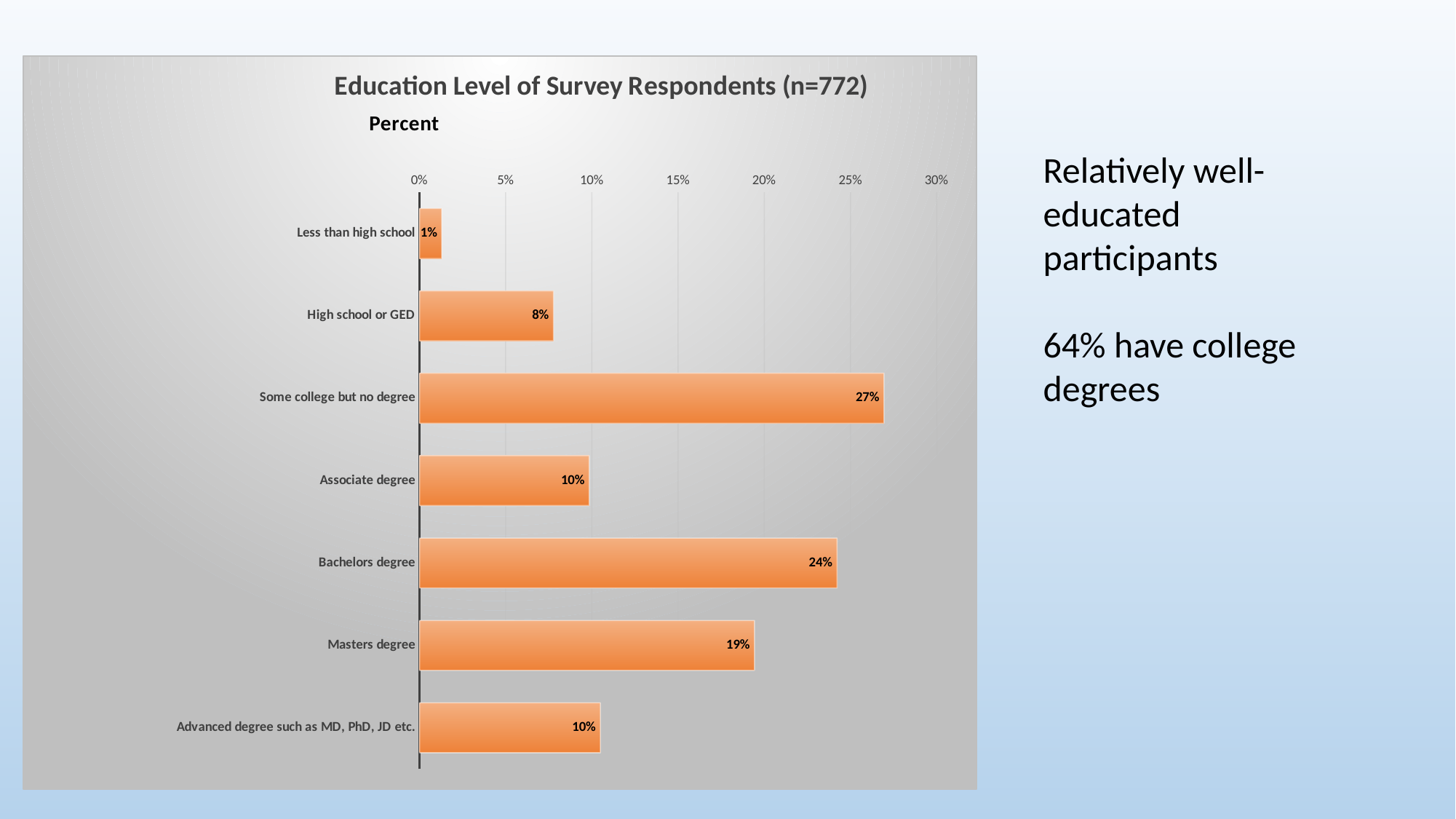
How many education level categories are shown in the chart? 7 What percentage of respondents have High school or GED as their education level? 8% Is the value for Bachelors degree greater or less than 20%? greater Which education level has the lowest percentage of respondents? Less than high school What is the title of the chart? Education Level of Survey Respondents (n=772) Which education level has the highest percentage of respondents? Some college but no degree Which is larger, the value for Masters degree or the value for Associate degree? Masters degree What is the difference in percentage points between Some college but no degree and Bachelors degree? 3% What kind of chart is shown on the slide? Bar chart What percentage of survey respondents have a Bachelors degree? 24% What is the value shown for Masters degree? 19% What is the difference between the values for High school or GED and Less than high school? 7%